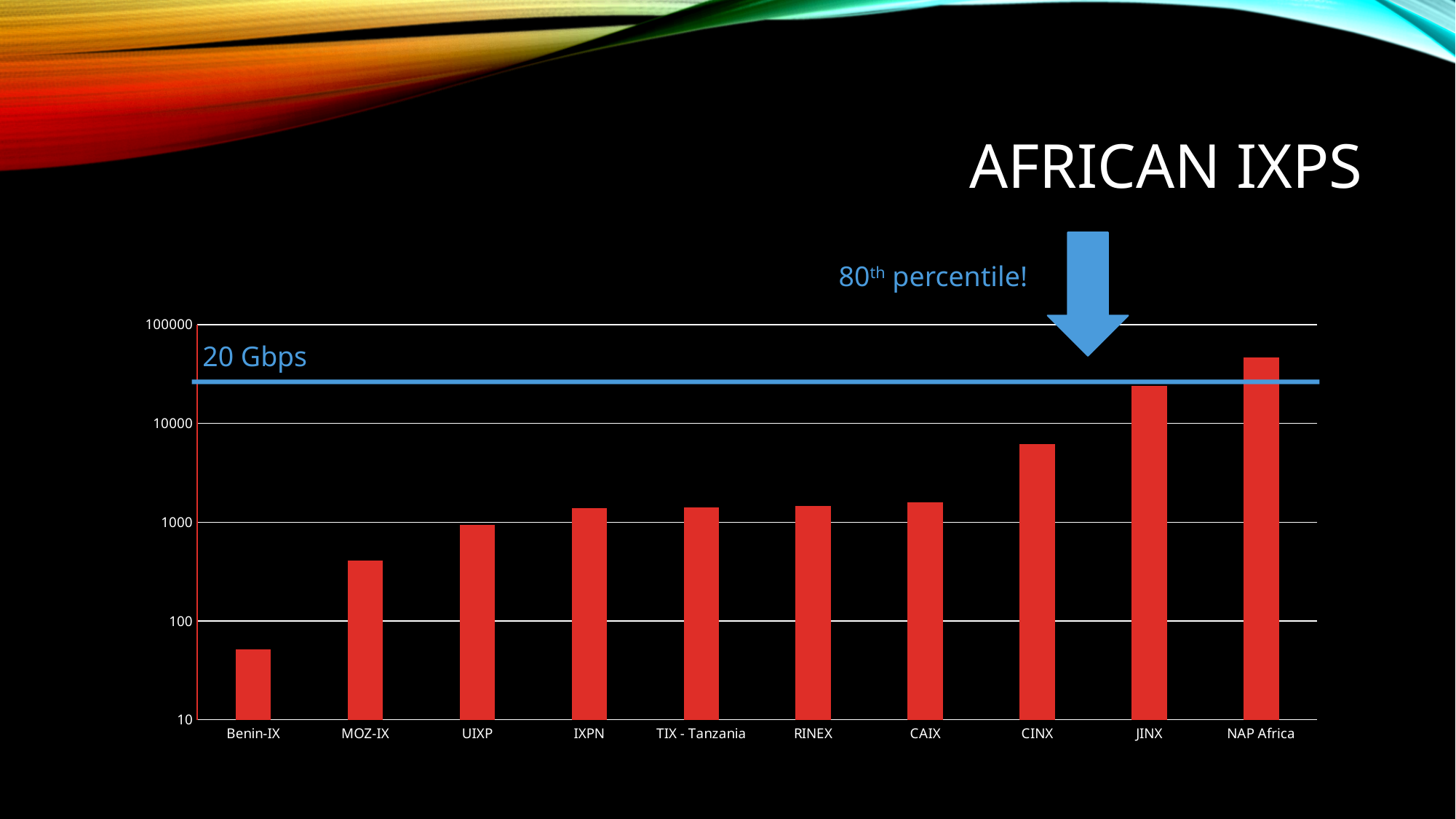
Is the value for JINX greater or less than 10000? greater Is the value for CINX greater or less than 10000? less Is the value for MOZ-IX greater or less than 1000? less What label is written on the horizontal blue line drawn across the chart? 20 Gbps Which IXP has the highest bar on the chart? NAP Africa Which IXP has the lowest bar on the chart? Benin-IX Which is larger, the value for CINX or the value for JINX? JINX What kind of chart is shown on the slide? bar chart How many IXPs (categories) are plotted on the chart? 10 Do the bar values generally rise or fall from left to right along the x axis? rise